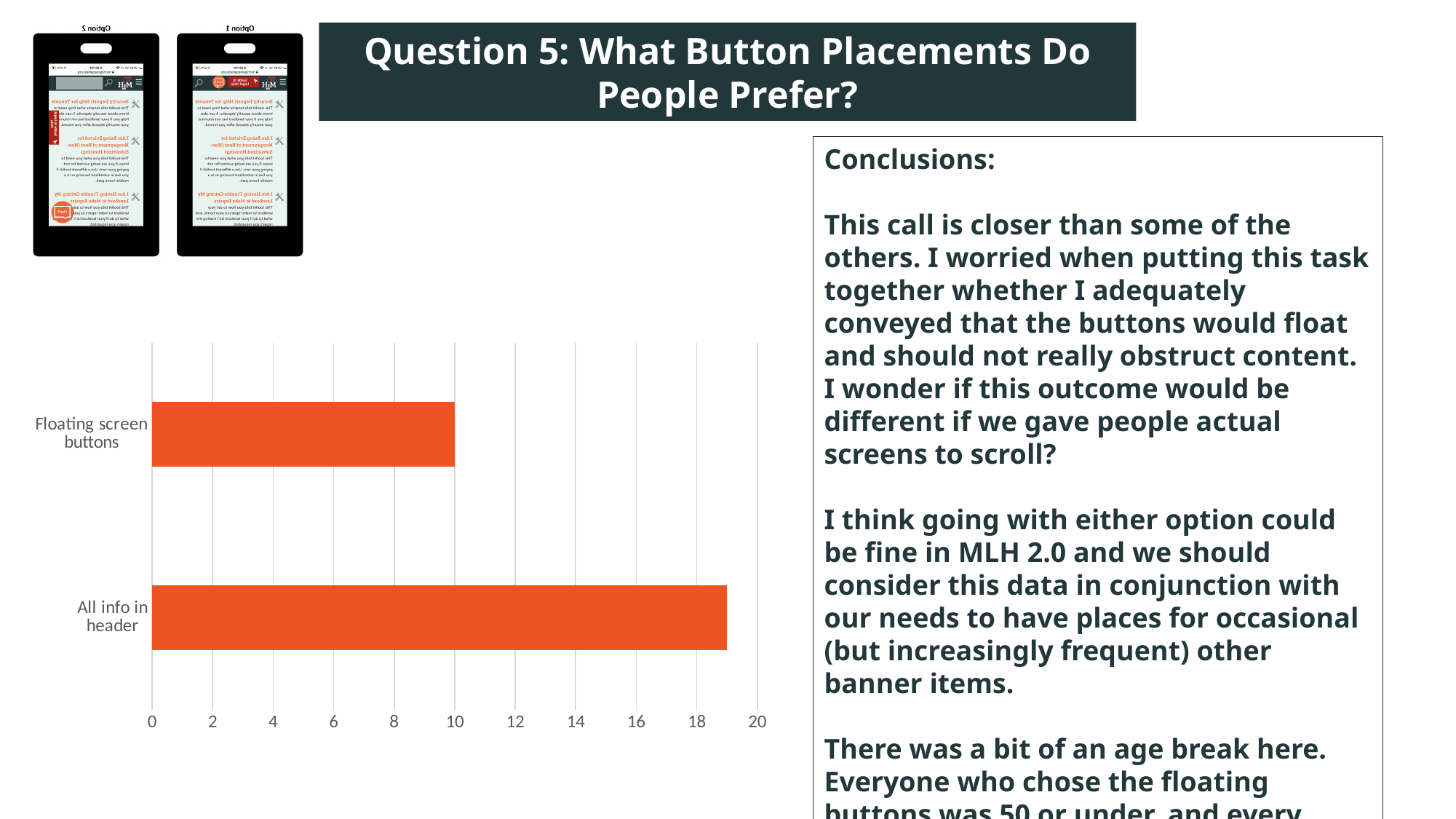
Which is larger, the value for All info in header or the value for Floating screen buttons? All info in header What is the value for Floating screen buttons? 10 What type of chart is shown on the slide? bar chart Which category has the lowest value? Floating screen buttons How many categories does the bar chart show? 2 What is the maximum value shown on the horizontal axis? 20 What colour are the bars in the chart? orange Is the value for Floating screen buttons greater or less than 12? less Which category has the highest value? All info in header Is the value for All info in header greater or less than 18? greater Is the value for All info in header greater or less than 20? less